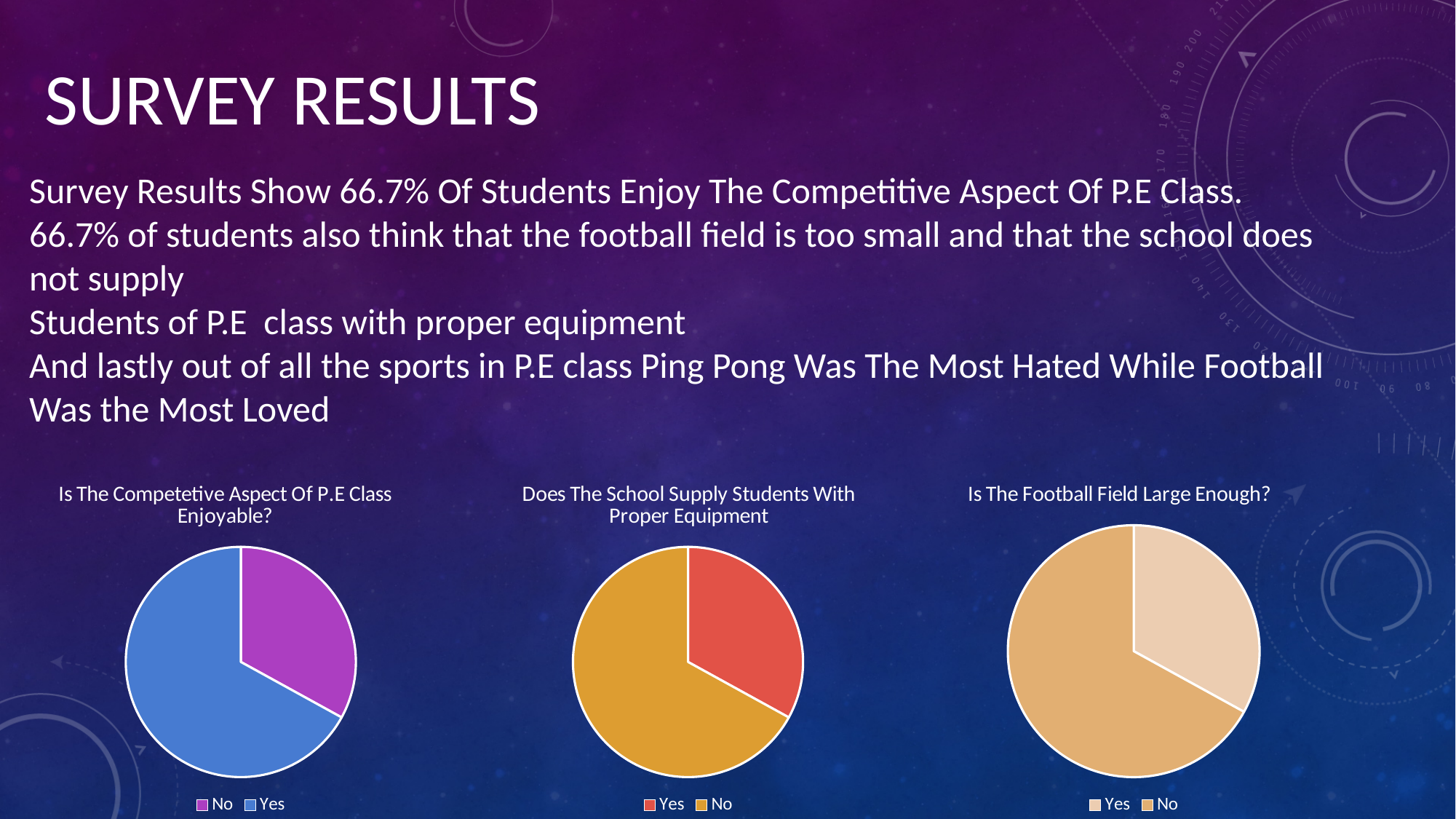
In the chart "Does The School Supply Students With Proper Equipment", is the Yes slice or the No slice larger? No In the chart "Does The School Supply Students With Proper Equipment", which response has the largest slice? No How many slices does the pie chart "Is The Football Field Large Enough?" have? 2 In the chart "Is The Competetive Aspect Of P.E Class Enjoyable?", which response has the largest slice? Yes What kind of chart is "Is The Competetive Aspect Of P.E Class Enjoyable?"? Pie chart In the chart "Is The Football Field Large Enough?", is the Yes slice or the No slice larger? No In the chart "Does The School Supply Students With Proper Equipment", what colour is the Yes slice? Red In the chart "Is The Competetive Aspect Of P.E Class Enjoyable?", what colour is the Yes slice? Blue How many entries does the legend of "Does The School Supply Students With Proper Equipment" list? 2 How many pie charts are shown on the slide? 3 In the chart "Is The Football Field Large Enough?", which response has the smallest slice? Yes In the chart "Is The Competetive Aspect Of P.E Class Enjoyable?", which response has the smallest slice? No